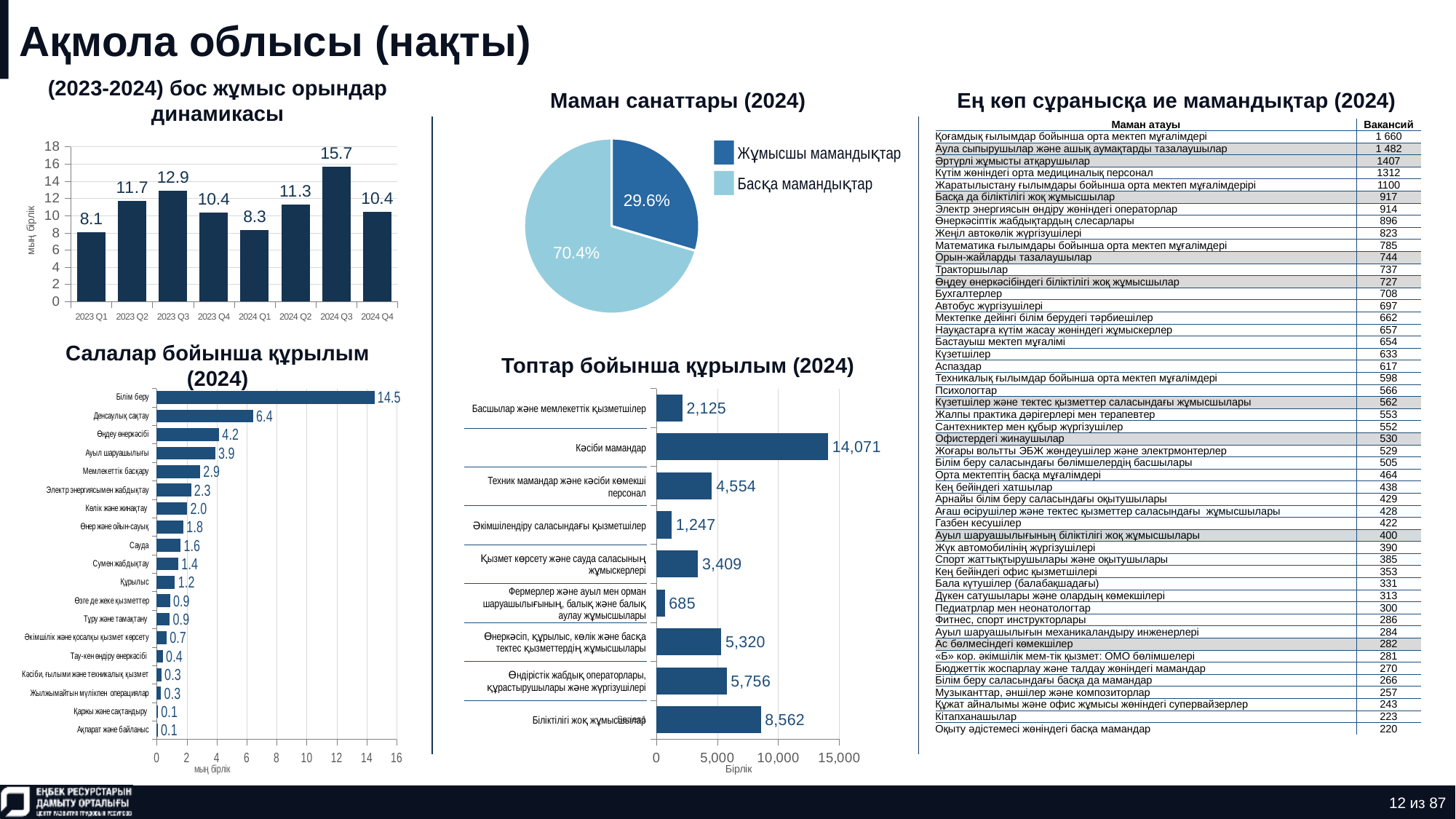
In the chart 'Топтар бойынша құрылым (2024)', what is the value for 'Кәсіби мамандар'? 14,071 In the chart 'Салалар бойынша құрылым (2024)', what is the value for 'Денсаулық сақтау'? 6.4 In the chart 'Салалар бойынша құрылым (2024)', which category has the highest value? Білім беру What kind of chart is 'Топтар бойынша құрылым (2024)'? Bar chart In the chart '(2023-2024) бос жұмыс орындар динамикасы', what is the difference between 2023 Q3 and 2023 Q1? 4.8 In the chart '(2023-2024) бос жұмыс орындар динамикасы', which quarter has the lowest value? 2023 Q1 In the pie chart 'Маман санаттары (2024)', how many entries does the legend list? 2 In the pie chart 'Маман санаттары (2024)', what share does 'Жұмысшы мамандықтар' have? 29.6% In the chart 'Топтар бойынша құрылым (2024)', which category has the lowest value? Фермерлер және ауыл мен орман шаруашылығының, балық және балық аулау жұмысшылары In the chart '(2023-2024) бос жұмыс орындар динамикасы', what is the value for 2024 Q3? 15.7 In the chart 'Салалар бойынша құрылым (2024)', which is larger: 'Өңдеу өнеркәсібі' or 'Мемлекеттік басқару'? Өңдеу өнеркәсібі In the chart '(2023-2024) бос жұмыс орындар динамикасы', how many quarters are plotted? 8